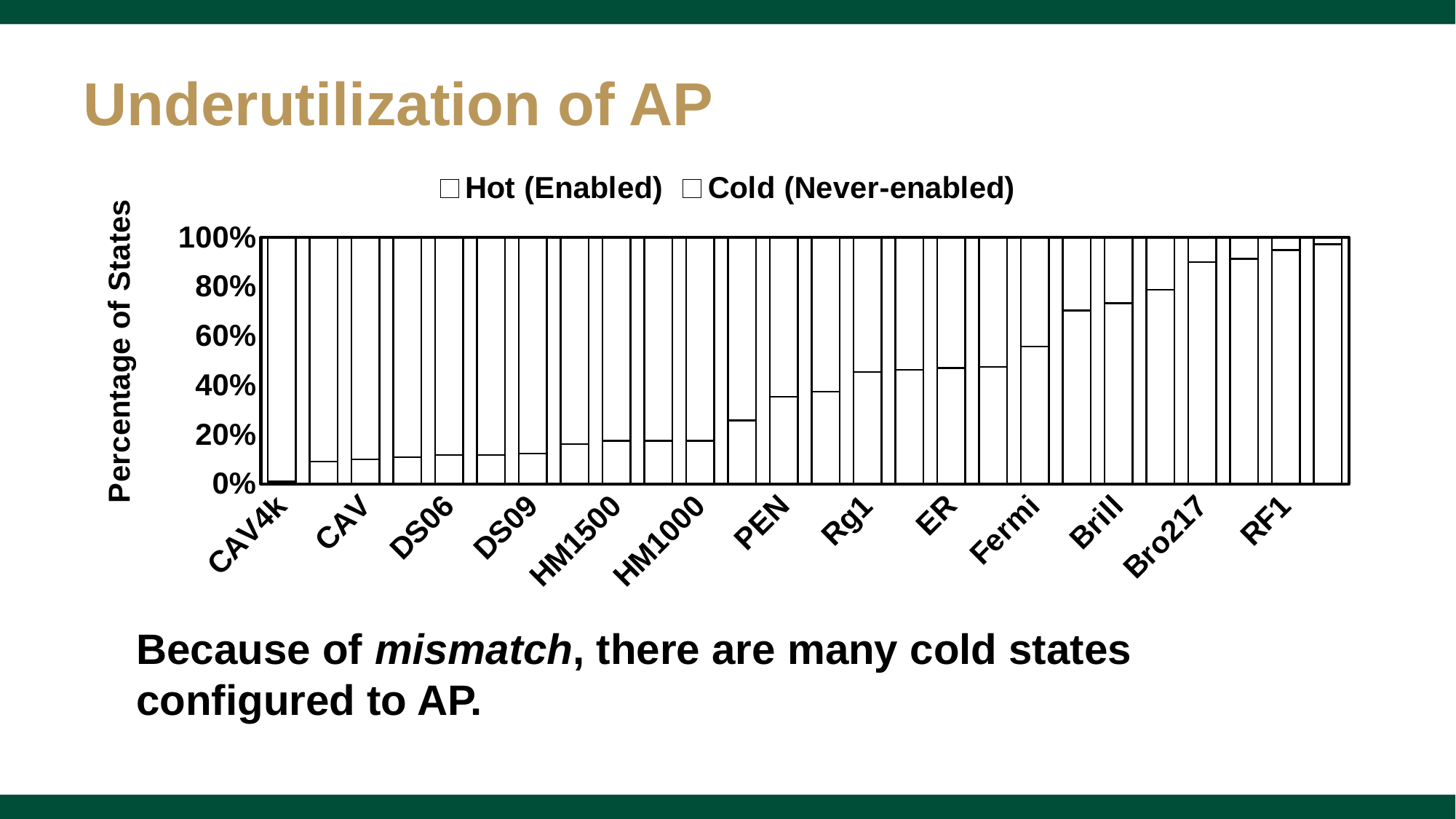
What kind of chart is shown on the slide? bar chart Is the Hot (Enabled) value for Brill greater or less than 60%? greater Does the Hot (Enabled) share rise or fall moving from left to right along the x axis? rise Is the Hot (Enabled) value for CAV greater or less than 20%? less How many series does the legend list? 2 Which labeled category has the lowest Hot (Enabled) share? CAV4k Is the Hot (Enabled) value for CAV4k greater or less than 20%? less Which has a larger Hot (Enabled) share, RF1 or CAV4k? RF1 What is the title of the y axis? Percentage of States What are the two series named in the legend? Hot (Enabled) and Cold (Never-enabled)